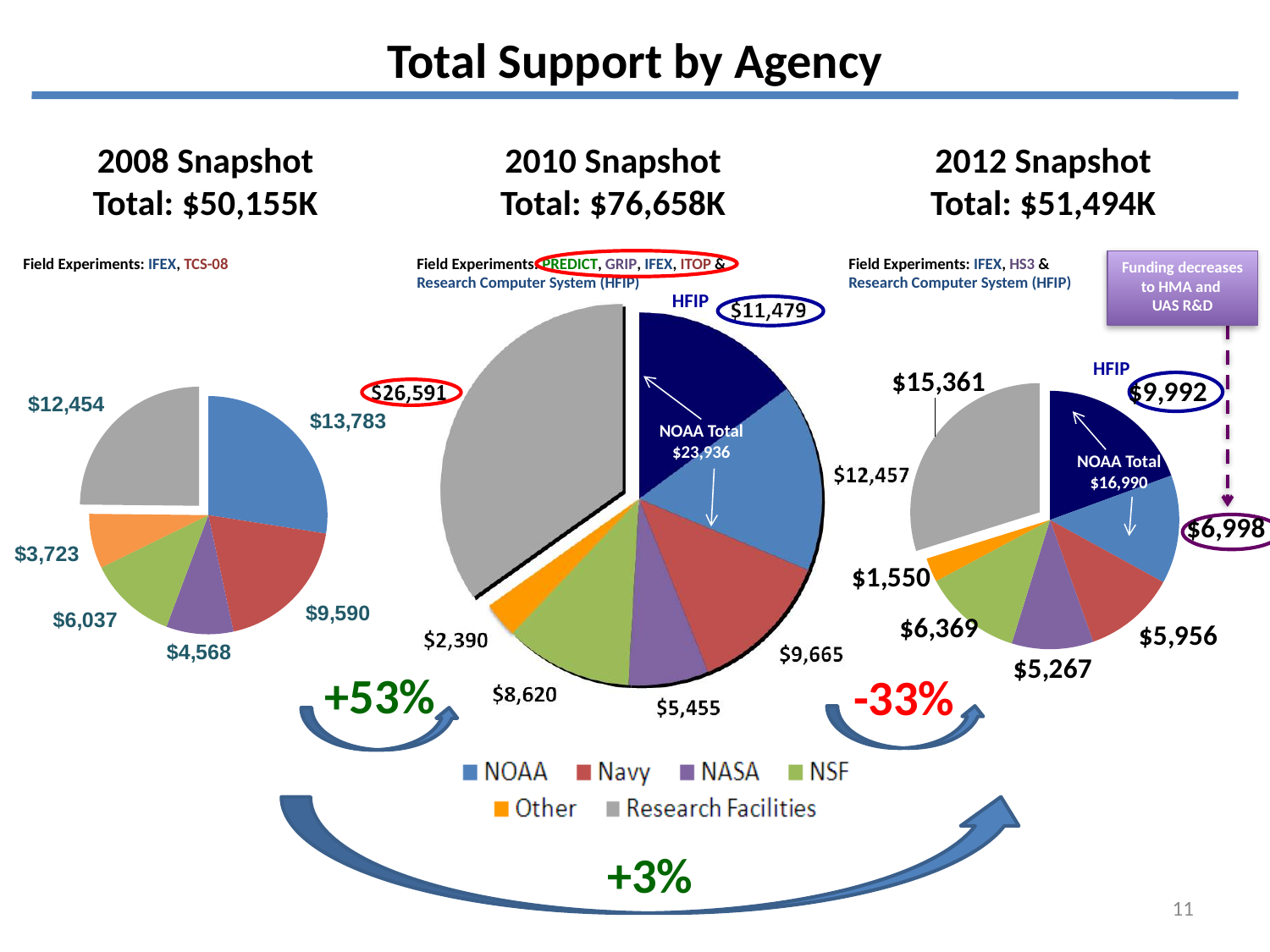
In the 2010 Snapshot pie chart, what is the value for Research Facilities? $26,591 In the 2012 Snapshot pie chart, what is the difference between the NSF value and the Navy value? $413 In the 2008 Snapshot pie chart, what is the value for Research Facilities? $12,454 In the 2008 Snapshot pie chart, which category has the smallest value? Other In the 2010 Snapshot pie chart, which category has the largest slice? Research Facilities In the 2012 Snapshot pie chart, which is larger, the Navy value or the NASA value? Navy What kind of charts are shown on the slide? Pie charts What is the total shown for the 2010 Snapshot? $76,658K How many agencies/categories does the legend list? 6 In the 2010 Snapshot pie chart, what is the NOAA Total? $23,936 In the 2008 Snapshot pie chart, what is the value for NASA? $4,568 In the 2012 Snapshot pie chart, what is the value for HFIP? $9,992